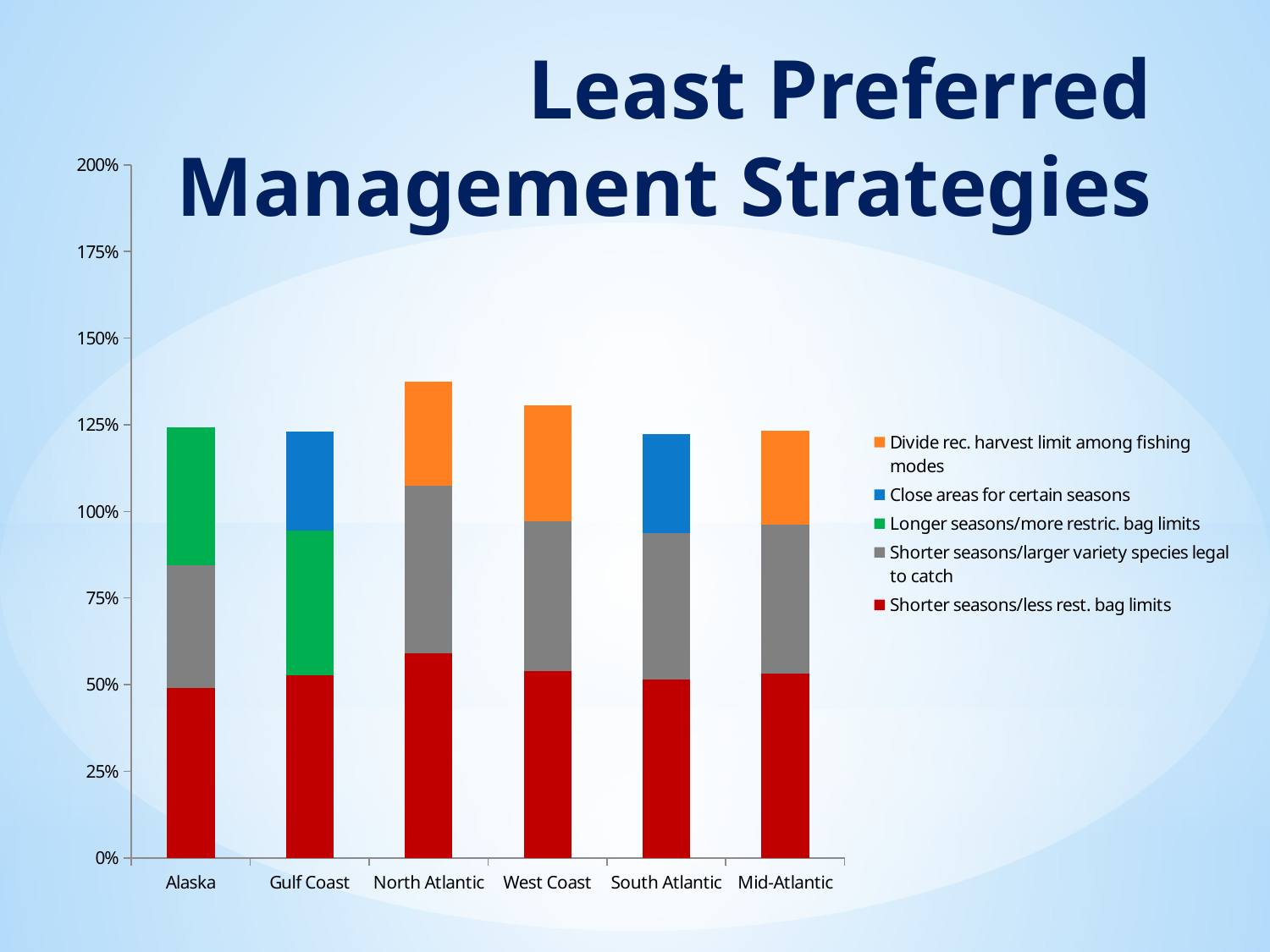
How many series does the chart's legend list? 5 Which regions' bars include a 'Close areas for certain seasons' segment? Gulf Coast and South Atlantic Is the total stacked value for Gulf Coast greater or less than 150%? less Is the total stacked value for West Coast greater or less than 125%? greater What is the title of the slide containing the chart? Least Preferred Management Strategies What kind of chart is shown on the slide? Stacked bar chart Which region has the tallest stacked bar overall? North Atlantic How many regions are shown along the x axis of the chart? 6 Which region has the largest 'Shorter seasons/less rest. bag limits' segment? North Atlantic Which has the taller stacked bar overall, North Atlantic or West Coast? North Atlantic Is the 'Shorter seasons/less rest. bag limits' value for North Atlantic greater or less than 50%? greater